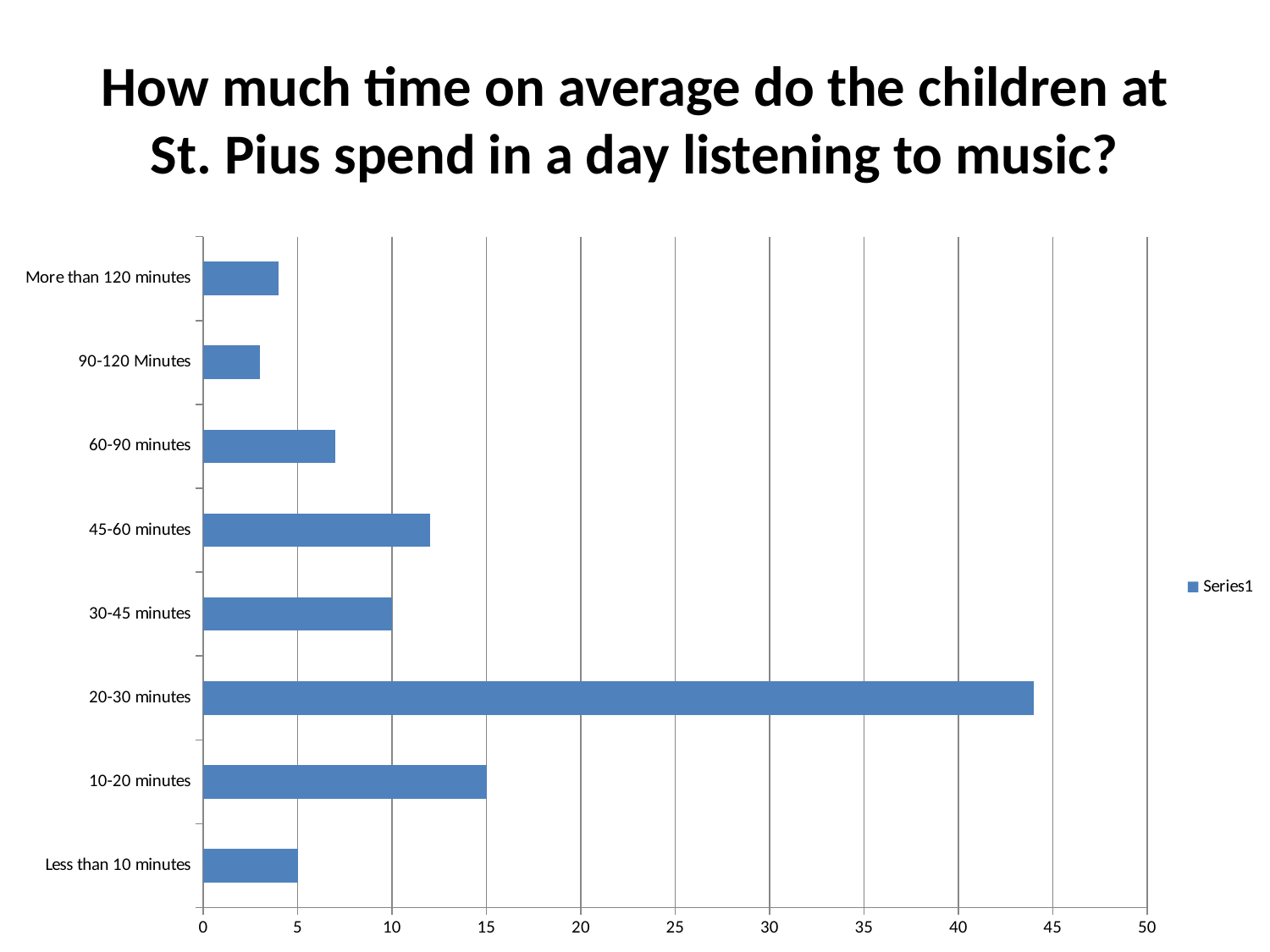
What is the difference between the values for 10-20 minutes and Less than 10 minutes? 10 What is the value for 30-45 minutes? 10 Is the value for More than 120 minutes greater or less than 5? less Which category has the highest value? 20-30 minutes What is the value for 10-20 minutes? 15 What is the name of the series shown in the legend? Series1 How many categories are shown on the chart? 8 What is the value for Less than 10 minutes? 5 Which is larger, the value for 45-60 minutes or the value for 60-90 minutes? 45-60 minutes Is the value for 20-30 minutes greater or less than 40? greater What type of chart is shown on the slide? Bar chart How many series does the legend list? 1